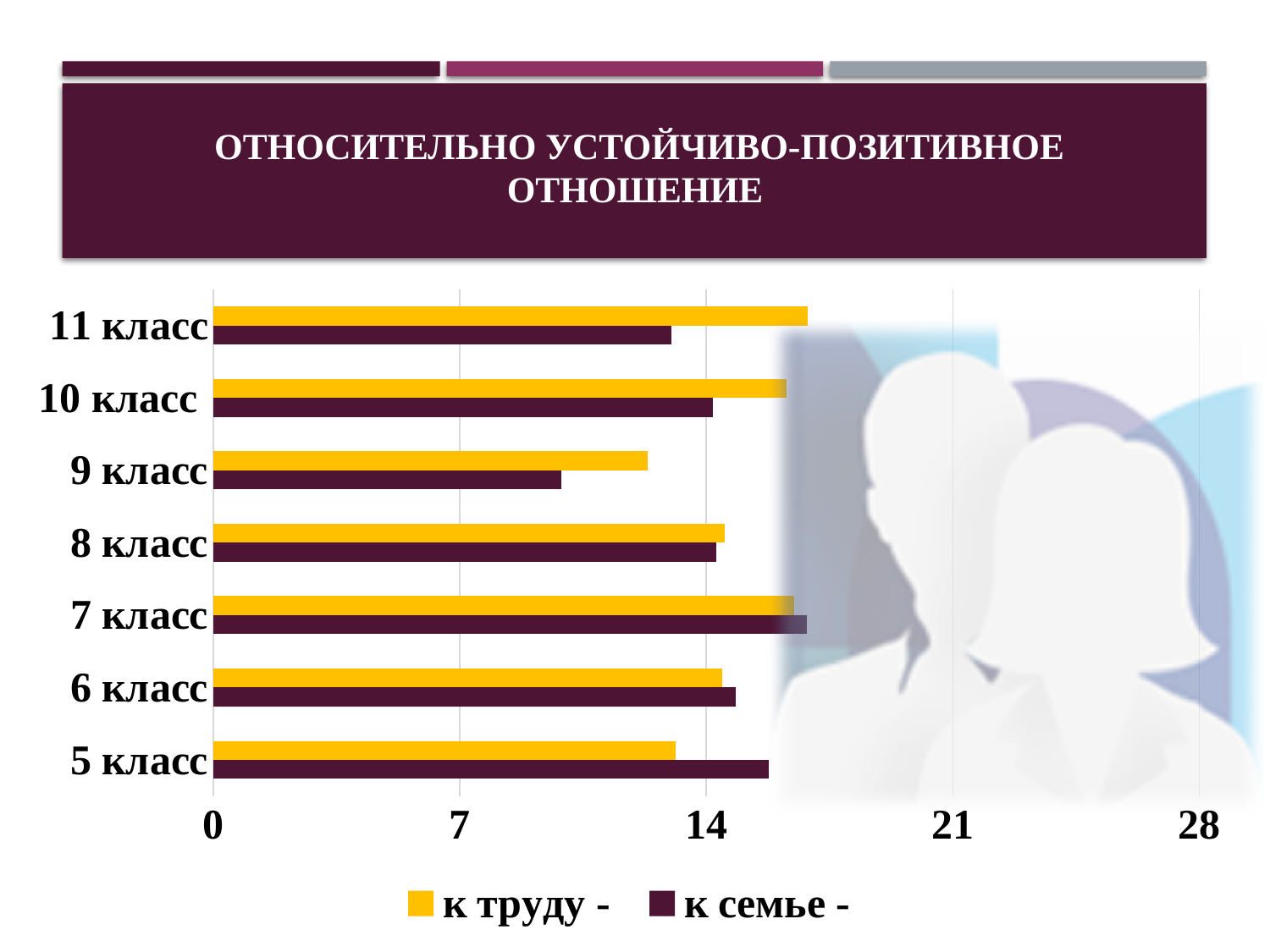
Which class has the lowest value for "к труду -"? 9 класс Which class has the highest value for "к семье -"? 7 класс Is the value for "к труду -" in 9 класс greater or less than 14? less How many classes (categories) are shown on the chart? 7 Is the value for "к труду -" in 11 класс greater or less than 14? greater What kind of chart is shown on the slide? bar chart Which colour represents the series "к труду -" in the legend? yellow For 5 класс, which series has the larger value, "к труду -" or "к семье -"? к семье - How many series does the legend list? 2 Which class has the lowest value for "к семье -"? 9 класс For 11 класс, which series has the larger value, "к труду -" or "к семье -"? к труду - Is the value for "к семье -" in 5 класс greater or less than 14? greater